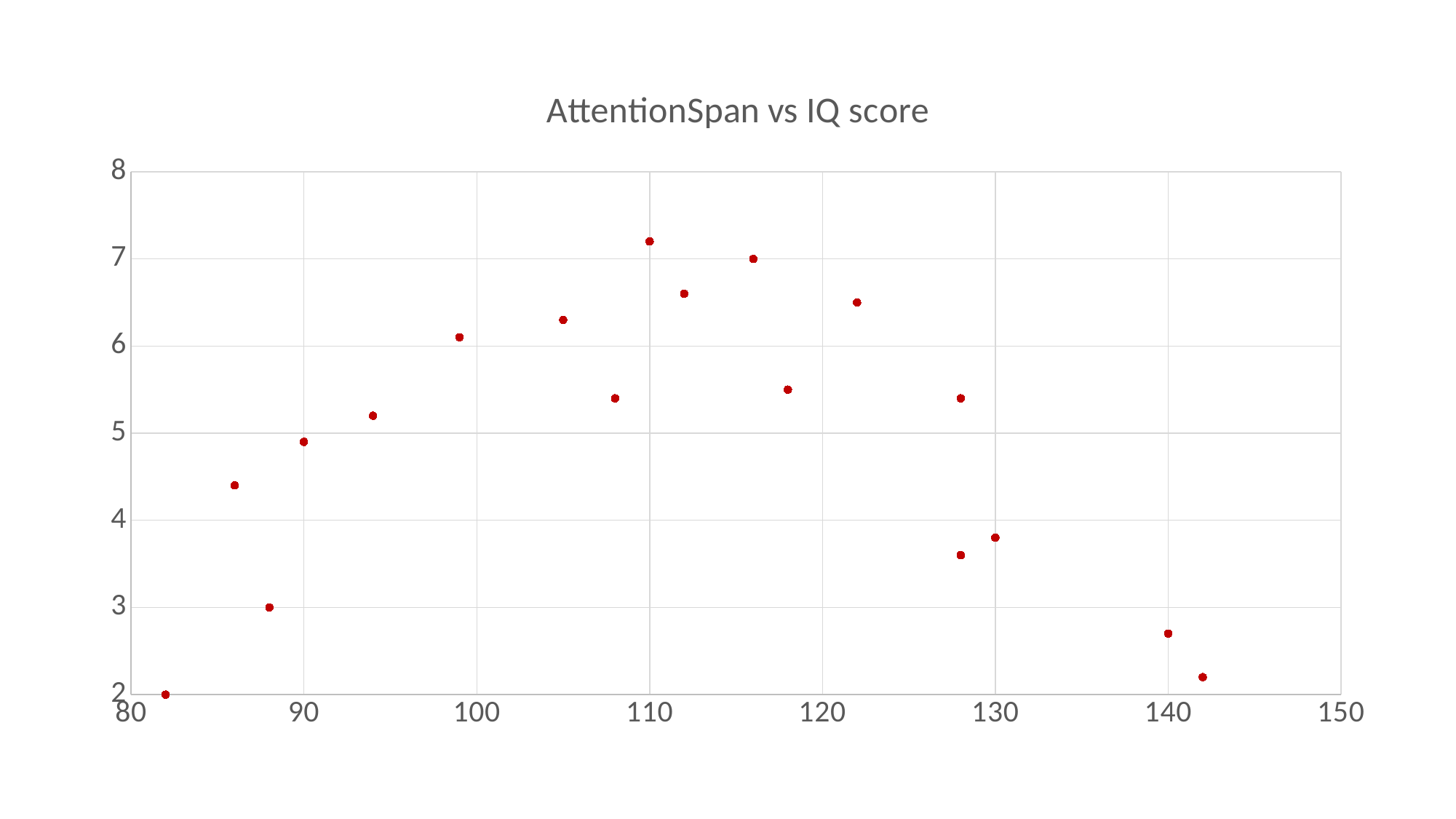
Do the plotted values generally rise or fall as the IQ score increases from 120 to 150? fall What is the highest value shown on the y axis? 8 Is the value for the point at IQ score 130 greater or less than 4? less What is the title of the chart? AttentionSpan vs IQ score What kind of chart is shown on the slide? scatter plot Is the value for the point at IQ score 110 greater or less than 6? greater Which is larger, the value for the point at IQ score 110 or the point at IQ score 140? 110 Is the value for the point at IQ score 140 greater or less than 3? less Do the plotted values generally rise or fall as the IQ score increases from 80 to 110? rise How many data points are plotted on the chart? 18 At which IQ score on the x axis does the highest plotted point occur? 110